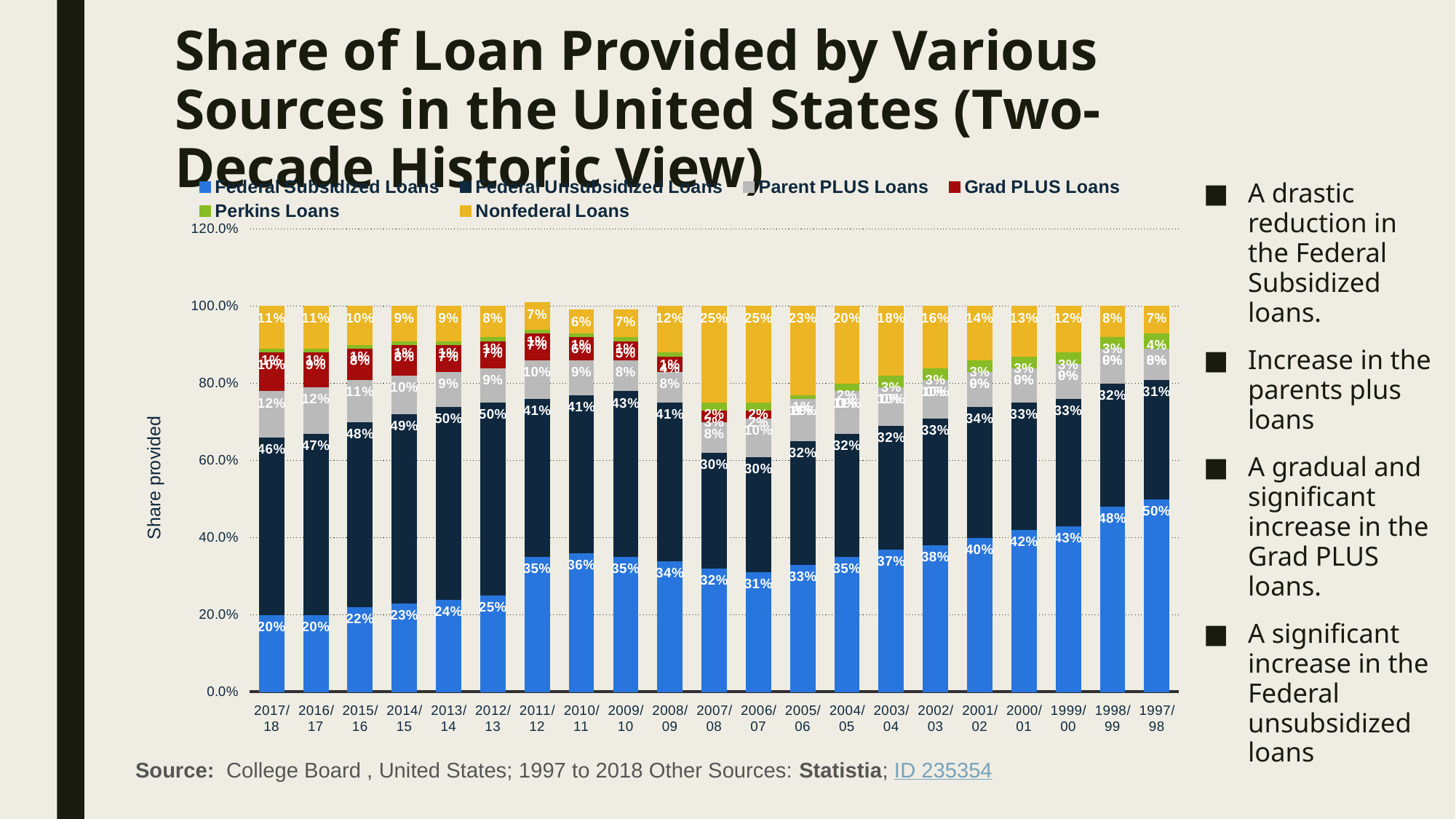
How many series does the legend list? 6 In which year is the Nonfederal Loans share the lowest? 2010/11 What is the difference between the Federal Subsidized Loans share in 1997/98 and in 2017/18? 30 percentage points What is the Nonfederal Loans share for 2007/08? 25% Moving from left to right along the x axis (2017/18 to 1997/98), does the Federal Subsidized Loans share rise or fall? Rise What is the Federal Subsidized Loans share for 2017/18? 20% Which is larger: the Nonfederal Loans share in 2007/08 or in 2017/18? 2007/08 In which year is the Federal Subsidized Loans share the highest? 1997/98 What is the Federal Unsubsidized Loans share for 2013/14? 50% How many academic years are shown on the x axis? 21 What kind of chart is shown on the slide? Stacked bar chart What is the Federal Subsidized Loans share for 1997/98? 50%